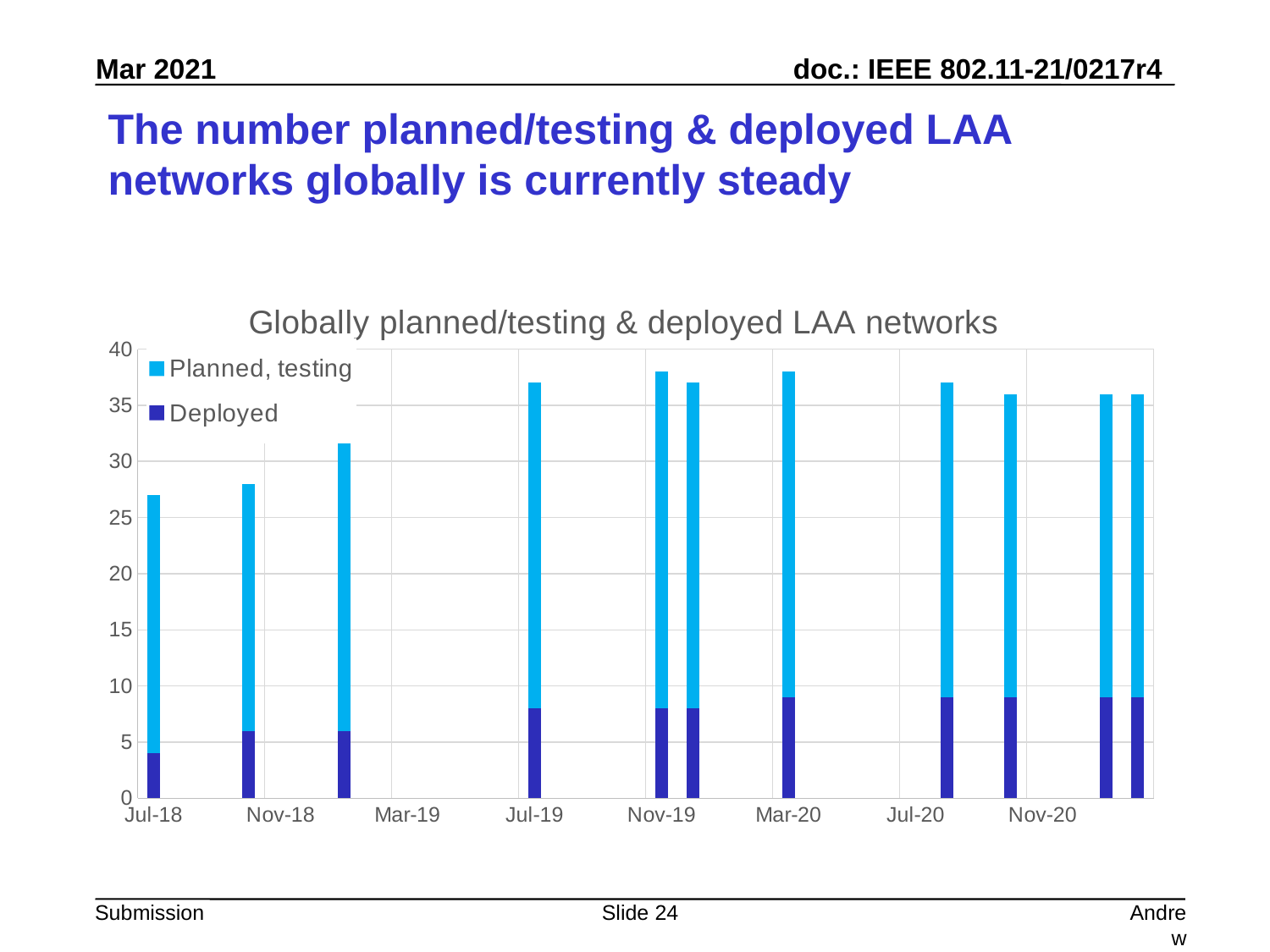
How many bars are plotted in the chart? 11 What kind of chart is shown on the slide? Stacked bar chart What are the two series named in the legend? Planned, testing; Deployed Is the total height of the Jul-19 bar greater or less than 35? greater Which bar has the lowest total, Jul-18 or Jul-19? Jul-18 Is the Deployed value for Mar-20 greater or less than 10? less Is the total height of the Jul-18 bar greater or less than 25? greater How many series does the legend list? 2 Do the total bar heights generally rise or fall from Jul-18 to Mar-20? rise Which date has the lowest total bar in the chart? Jul-18 What is the title of the chart? Globally planned/testing & deployed LAA networks